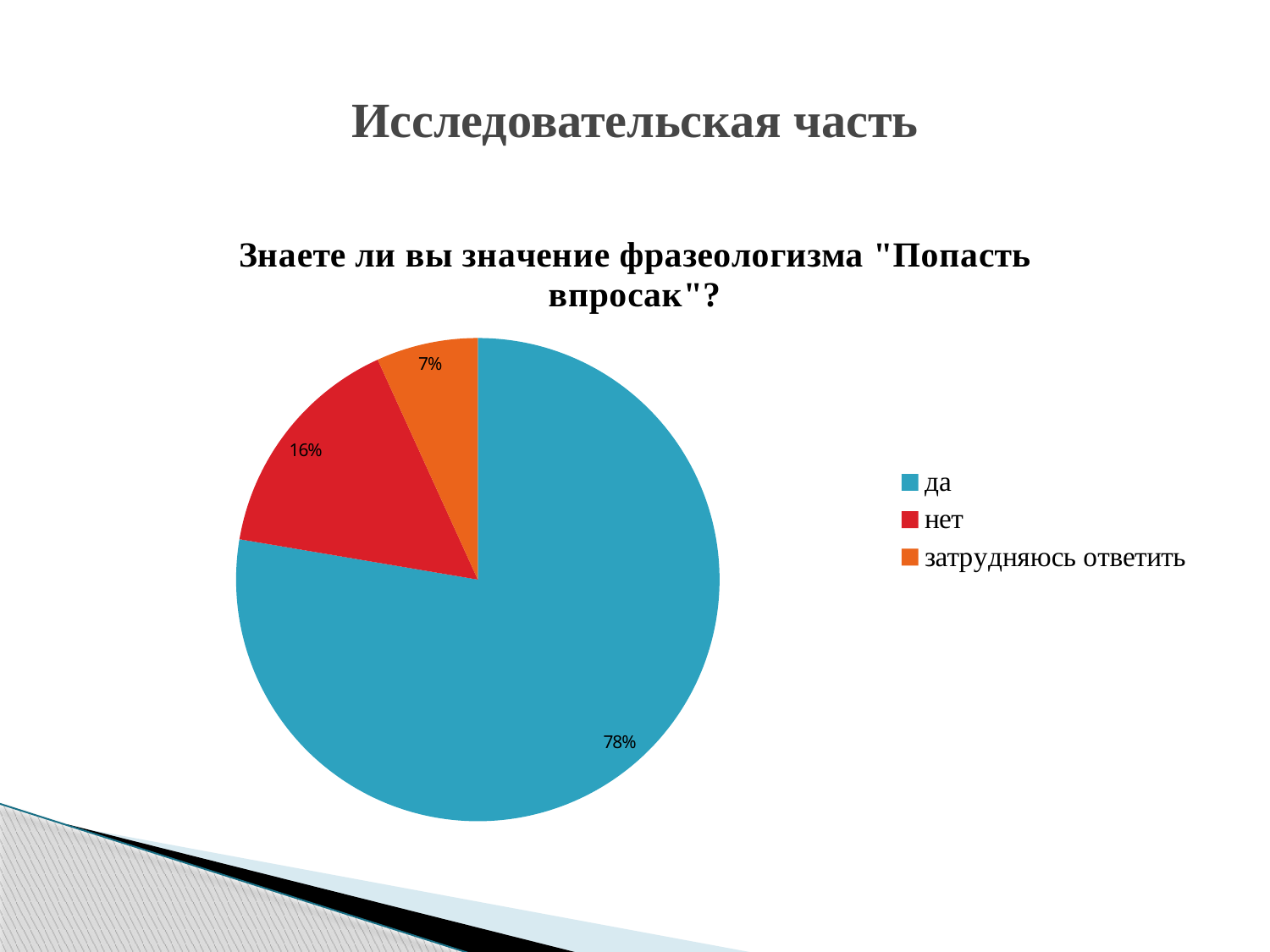
What percentage of respondents answered "да"? 78% How many slices does the pie chart have? 3 How many entries does the legend list? 3 What percentage of respondents answered "нет"? 16% Which is larger, the share for "нет" or the share for "затрудняюсь ответить"? нет What percentage of respondents answered "затрудняюсь ответить"? 7% Which answer has the smallest share of the pie? затрудняюсь ответить What colour is the slice for "нет"? red Which answer has the largest share of the pie? да What type of chart is shown on the slide? pie chart What is the difference in percentage points between "да" and "нет"? 62 What is the difference in percentage points between "нет" and "затрудняюсь ответить"? 9